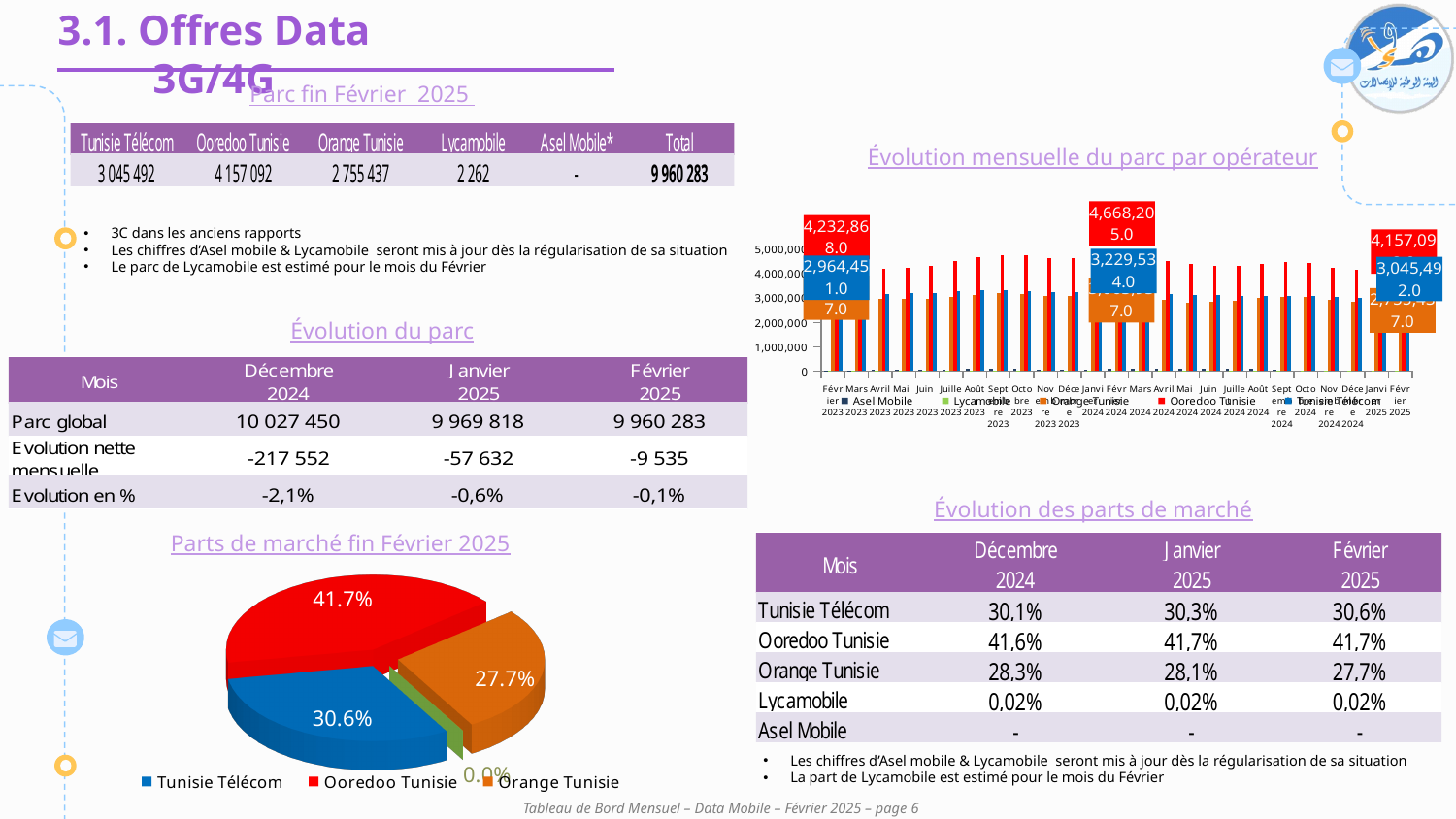
In the pie chart 'Parts de marché fin Février 2025', which operator has the largest slice? Ooredoo Tunisie In the pie chart 'Parts de marché fin Février 2025', which is larger: the slice for Tunisie Télécom or the slice for Orange Tunisie? Tunisie Télécom How many operators are listed in the legend of the pie chart 'Parts de marché fin Février 2025'? 3 In the chart 'Évolution mensuelle du parc par opérateur', is the value for Ooredoo Tunisie in Février 2025 greater or less than 4,000,000? greater What kind of chart is 'Évolution mensuelle du parc par opérateur'? Bar chart In the chart 'Évolution mensuelle du parc par opérateur', which operator has the tallest bar in Février 2025? Ooredoo Tunisie In the pie chart 'Parts de marché fin Février 2025', what is Ooredoo Tunisie's share of the pie? 41.7% In the pie chart 'Parts de marché fin Février 2025', what colour is the Ooredoo Tunisie slice? Red In the pie chart 'Parts de marché fin Février 2025', what share does Tunisie Télécom hold? 30.6% In the pie chart 'Parts de marché fin Février 2025', how many percentage points separate Ooredoo Tunisie from Tunisie Télécom? 11.1 How many series does the legend of the chart 'Évolution mensuelle du parc par opérateur' list? 5 In the pie chart 'Parts de marché fin Février 2025', what share does Orange Tunisie hold? 27.7%